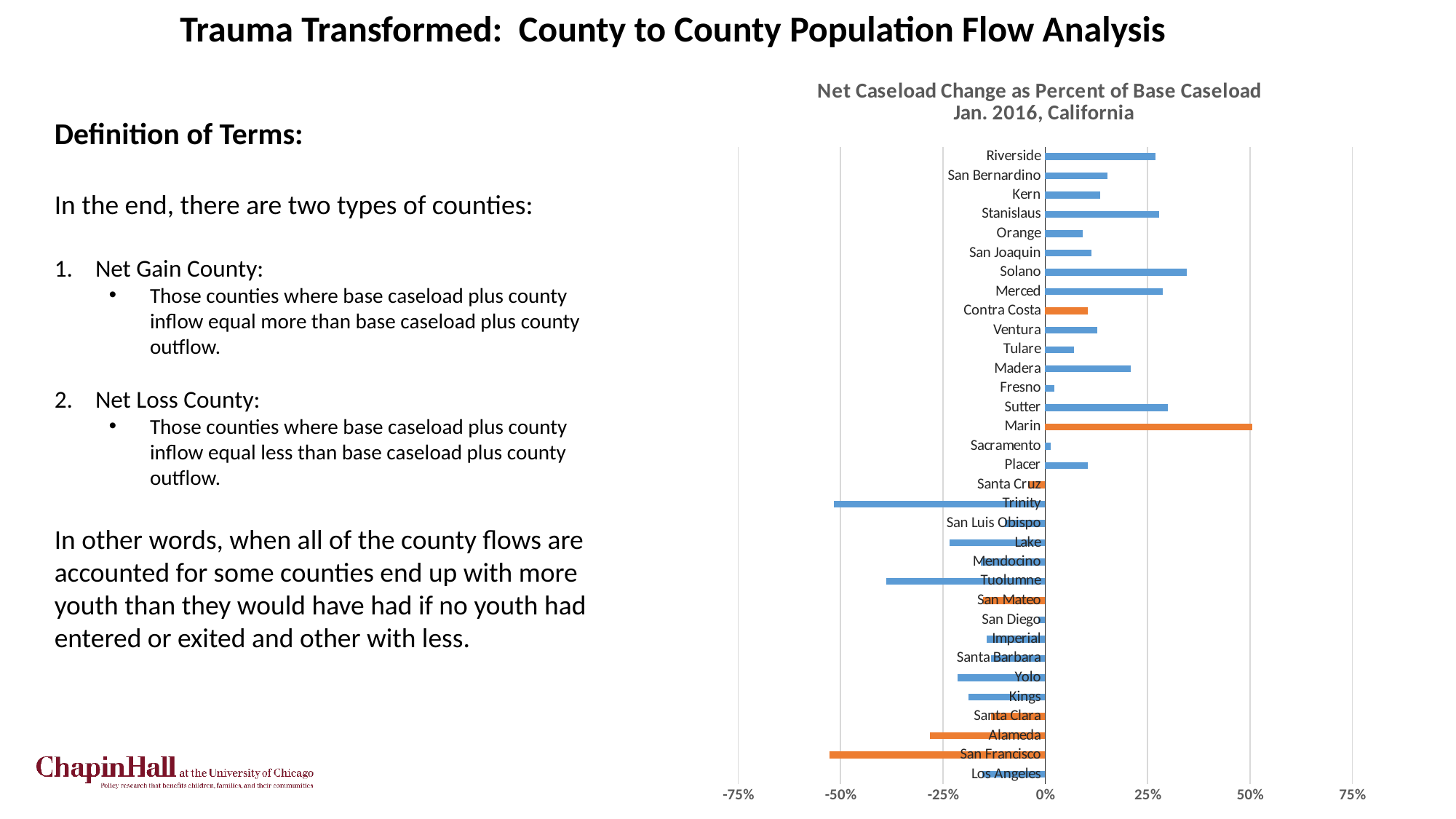
Is the value for Orange greater or less than 25%? less What type of chart is shown on the slide? bar chart Is the value for Solano greater or less than 25%? greater How many counties are plotted in the chart? 33 Is the value for Tuolumne greater or less than -25%? less Which county has the highest net caseload change as percent of base caseload? Marin Which has the larger value, Solano or Orange? Solano How many counties are drawn with orange bars in the chart? 7 Which has the larger value, Sutter or Fresno? Sutter What is the title of the chart? Net Caseload Change as Percent of Base Caseload Jan. 2016, California